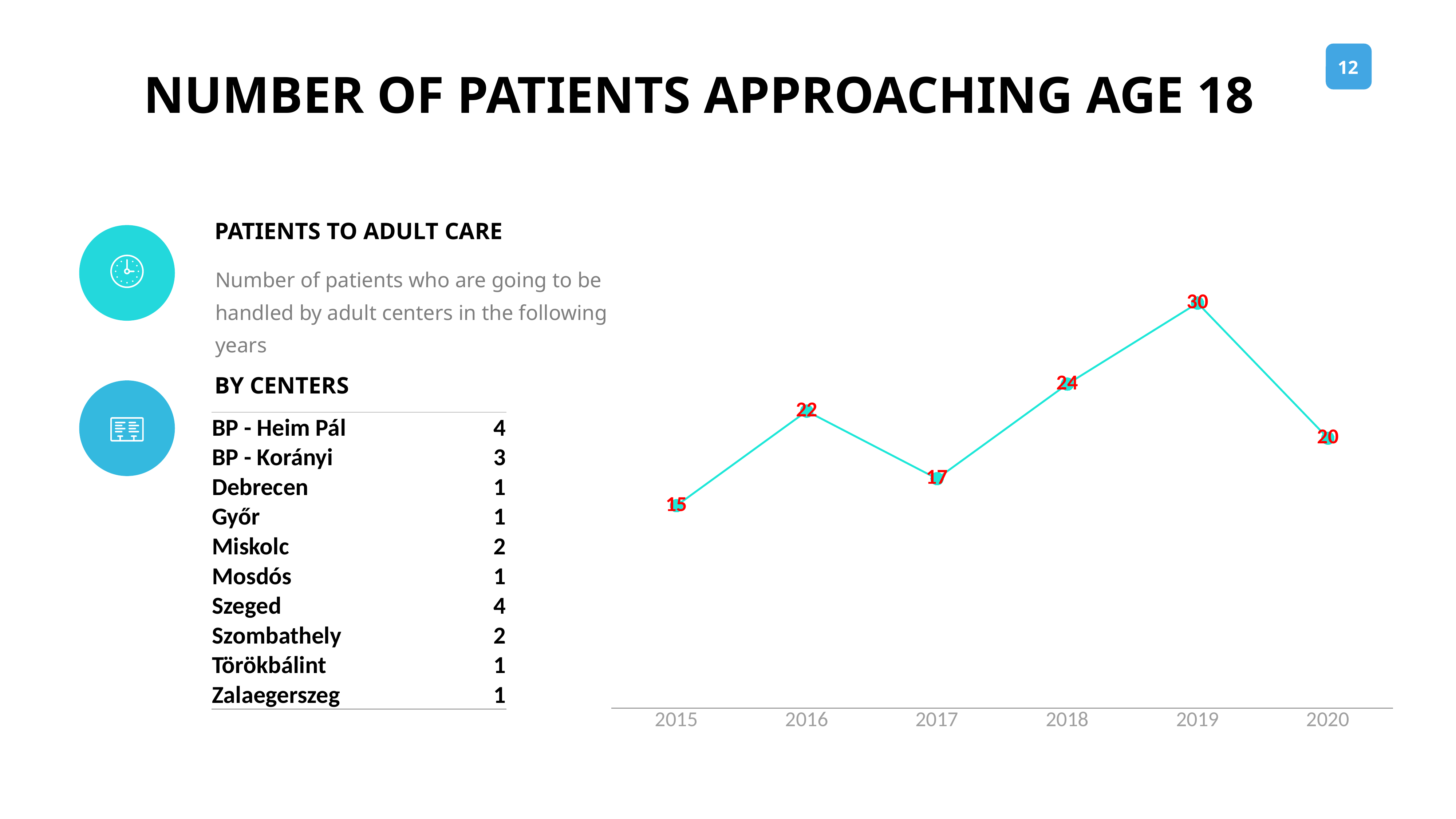
What is the value for 2019? 30 How many years are plotted on the chart? 6 Does the value rise or fall from 2019 to 2020? fall What is the difference between the values for 2019 and 2018? 6 What is the value for 2017? 17 What is the difference between the values for 2016 and 2017? 5 Which is larger, the value for 2016 or the value for 2020? 2016 Which year has the highest value? 2019 Which year has the lowest value? 2015 What is the value for 2020? 20 What is the value for 2015? 15 What kind of chart is shown on the slide? line chart